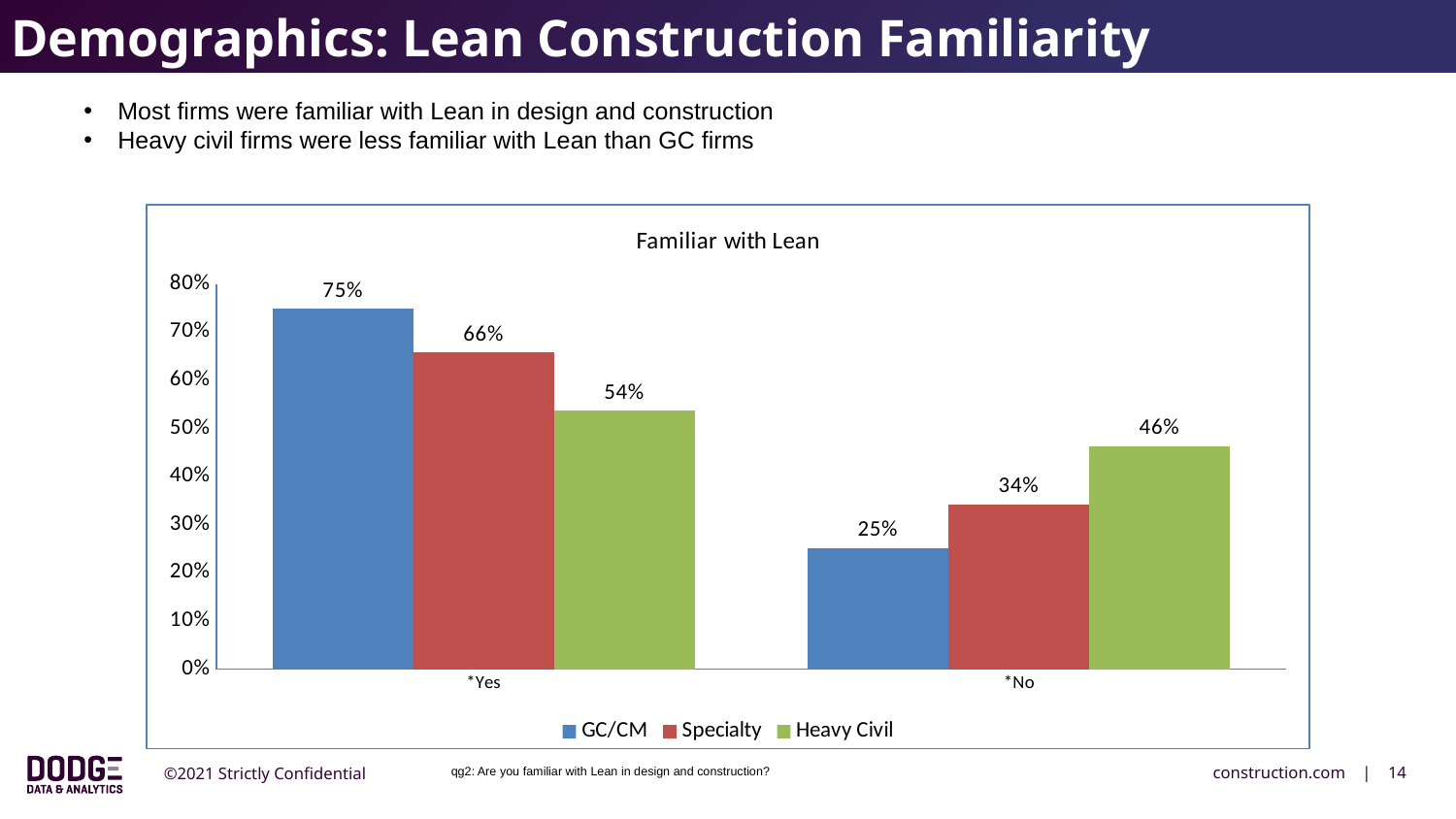
What is the value for GC/CM in the *Yes category? 75% Which series has the highest value in the *Yes category? GC/CM Which is larger: Specialty in *Yes or Specialty in *No? Specialty in *Yes What is the value for Specialty in the *Yes category? 66% What is the title of the chart? Familiar with Lean What colour represents Heavy Civil in the chart? Green What kind of chart is shown? Bar chart What is the value for Heavy Civil in the *No category? 46% How many categories are shown on the x axis? 2 Which series has the lowest value in the *No category? GC/CM How many series does the legend list? 3 What is the difference between the GC/CM and Heavy Civil values in the *Yes category? 21%